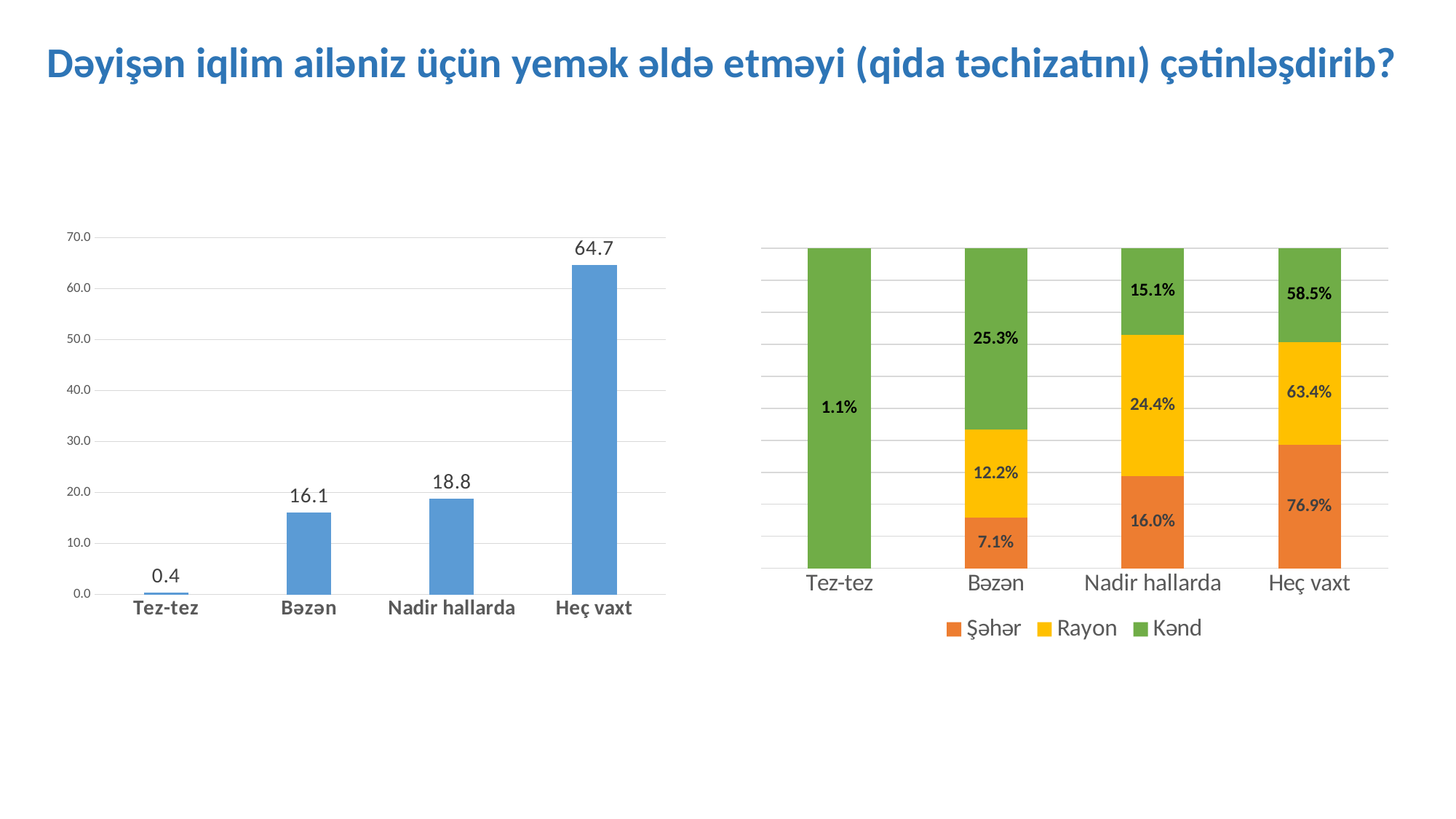
In the left chart, what is the difference between the values for Nadir hallarda and Bəzən? 2.7 How many series does the legend of the right chart list? 3 In the right chart, what is the Şəhər value for Heç vaxt? 76.9% In the left chart, which category has the lowest value? Tez-tez In the left chart, what is the value for Tez-tez? 0.4 In the left chart, how many categories are shown on the x axis? 4 In the right chart, which is larger for Nadir hallarda: the Şəhər value or the Rayon value? Rayon In the right chart, what is the Rayon value for Nadir hallarda? 24.4% In the right chart, what is the Kənd value for Bəzən? 25.3% In the left chart, which category has the highest value? Heç vaxt In the left chart, what is the value for Heç vaxt? 64.7 What kind of chart is the left chart? bar chart